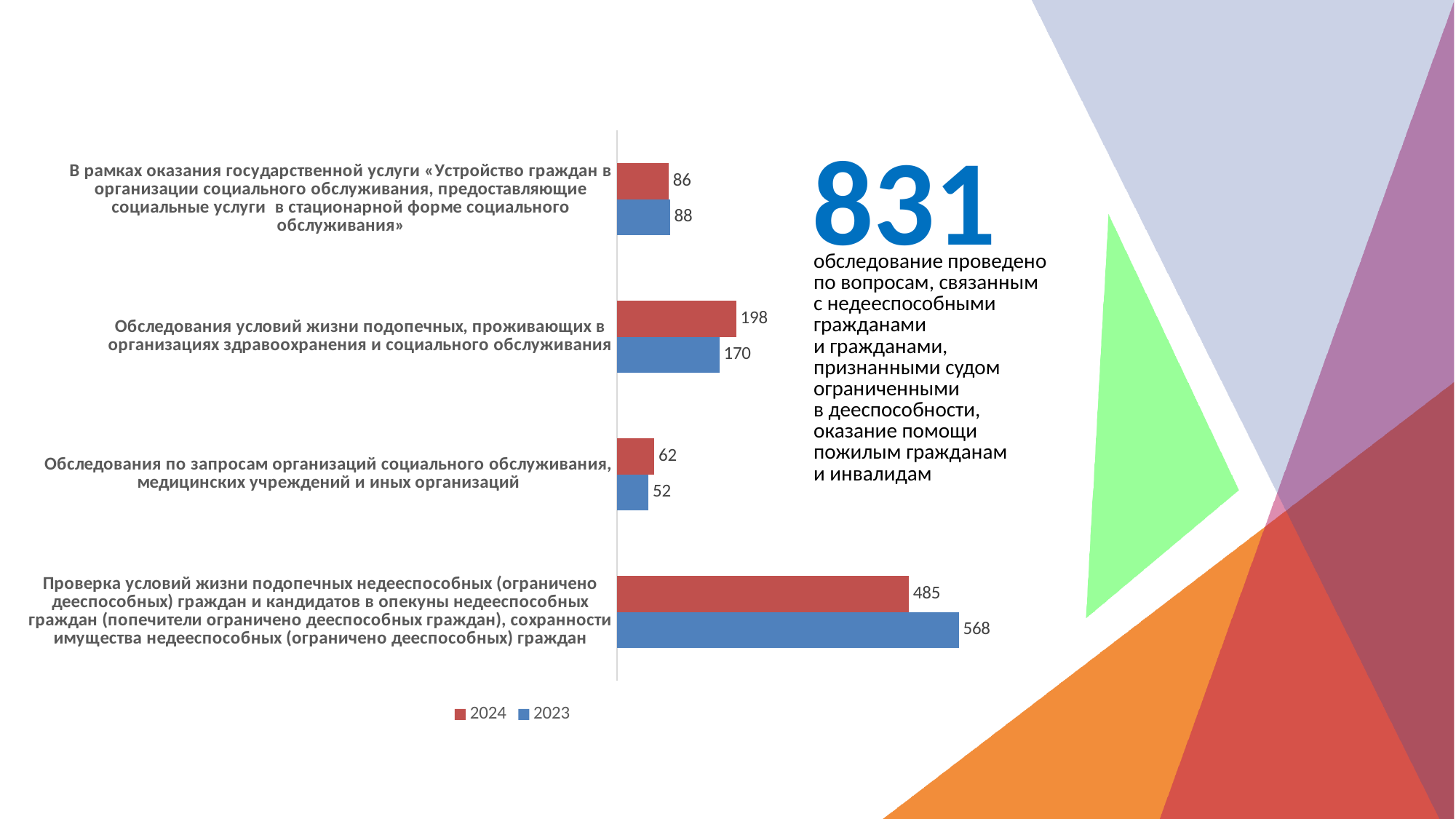
What is the 2023 value for «Обследования по запросам организаций социального обслуживания, медицинских учреждений и иных организаций»? 52 Which category has the lowest 2023 value? Обследования по запросам организаций социального обслуживания, медицинских учреждений и иных организаций What is the difference between the 2023 and 2024 values for «Проверка условий жизни подопечных недееспособных (ограничено дееспособных) граждан...»? 83 What is the difference between the 2024 and 2023 values for «Обследования условий жизни подопечных, проживающих в организациях здравоохранения и социального обслуживания»? 28 For «Обследования по запросам организаций социального обслуживания, медицинских учреждений и иных организаций», which year has the larger value, 2024 or 2023? 2024 What is the 2024 value for «Обследования условий жизни подопечных, проживающих в организациях здравоохранения и социального обслуживания»? 198 What type of chart is shown on the slide? Bar chart What is the 2023 value for «Проверка условий жизни подопечных недееспособных (ограничено дееспособных) граждан и кандидатов в опекуны...»? 568 How many series does the legend list? 2 What is the 2024 value for the category «В рамках оказания государственной услуги «Устройство граждан в организации социального обслуживания...»? 86 How many categories are shown in the bar chart? 4